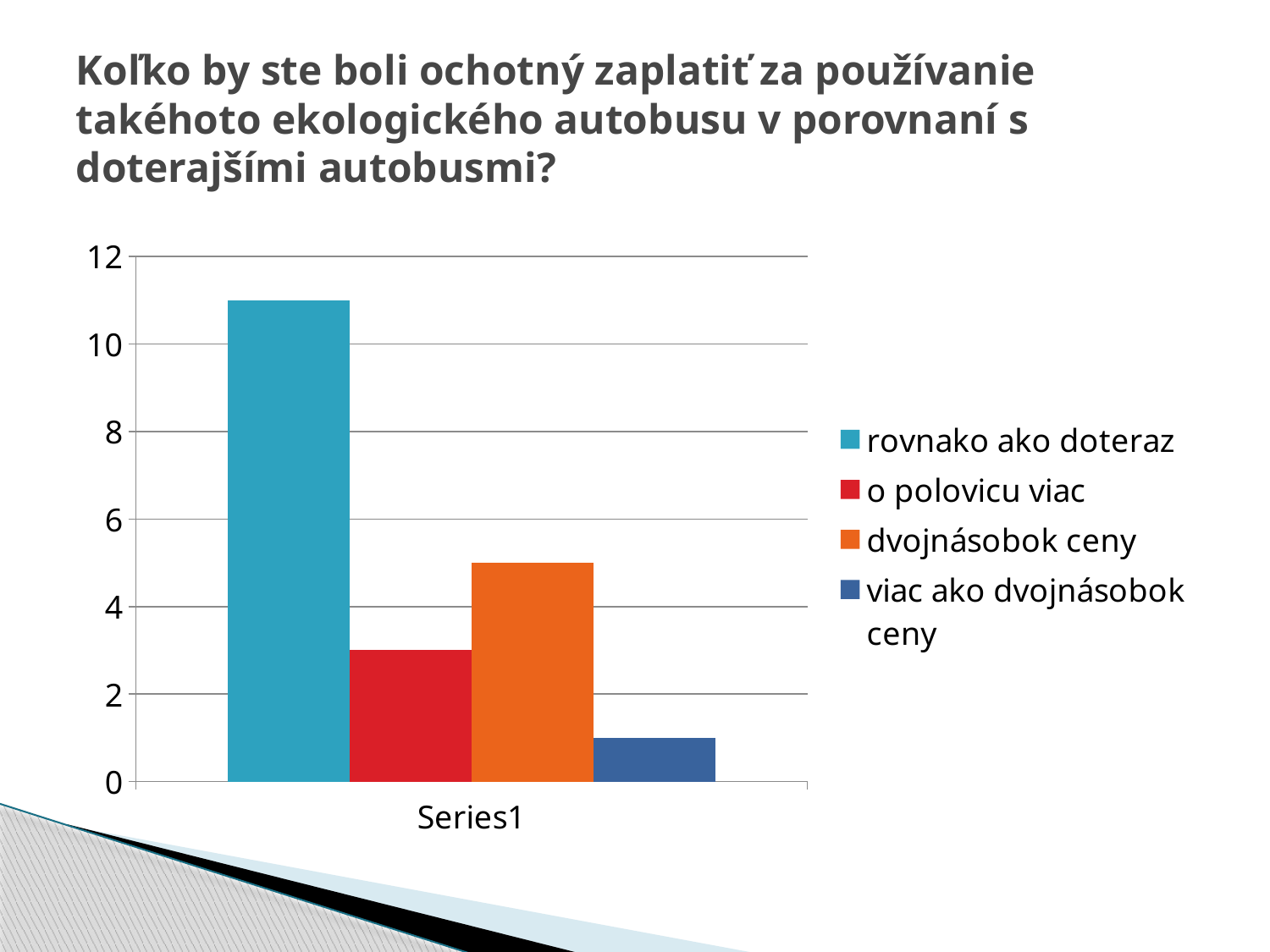
Is the value for 'o polovicu viac' greater or less than 4? less Which is larger, the value for 'o polovicu viac' or the value for 'dvojnásobok ceny'? dvojnásobok ceny What kind of chart is shown on the slide? bar chart What is the label shown on the x axis of the chart? Series1 Which series has the shortest bar? viac ako dvojnásobok ceny Is the value for 'rovnako ako doteraz' greater or less than 10? greater Is the value for 'viac ako dvojnásobok ceny' greater or less than 2? less What colour is the bar for 'dvojnásobok ceny'? orange How many series does the legend list? 4 Which series has the tallest bar? rovnako ako doteraz